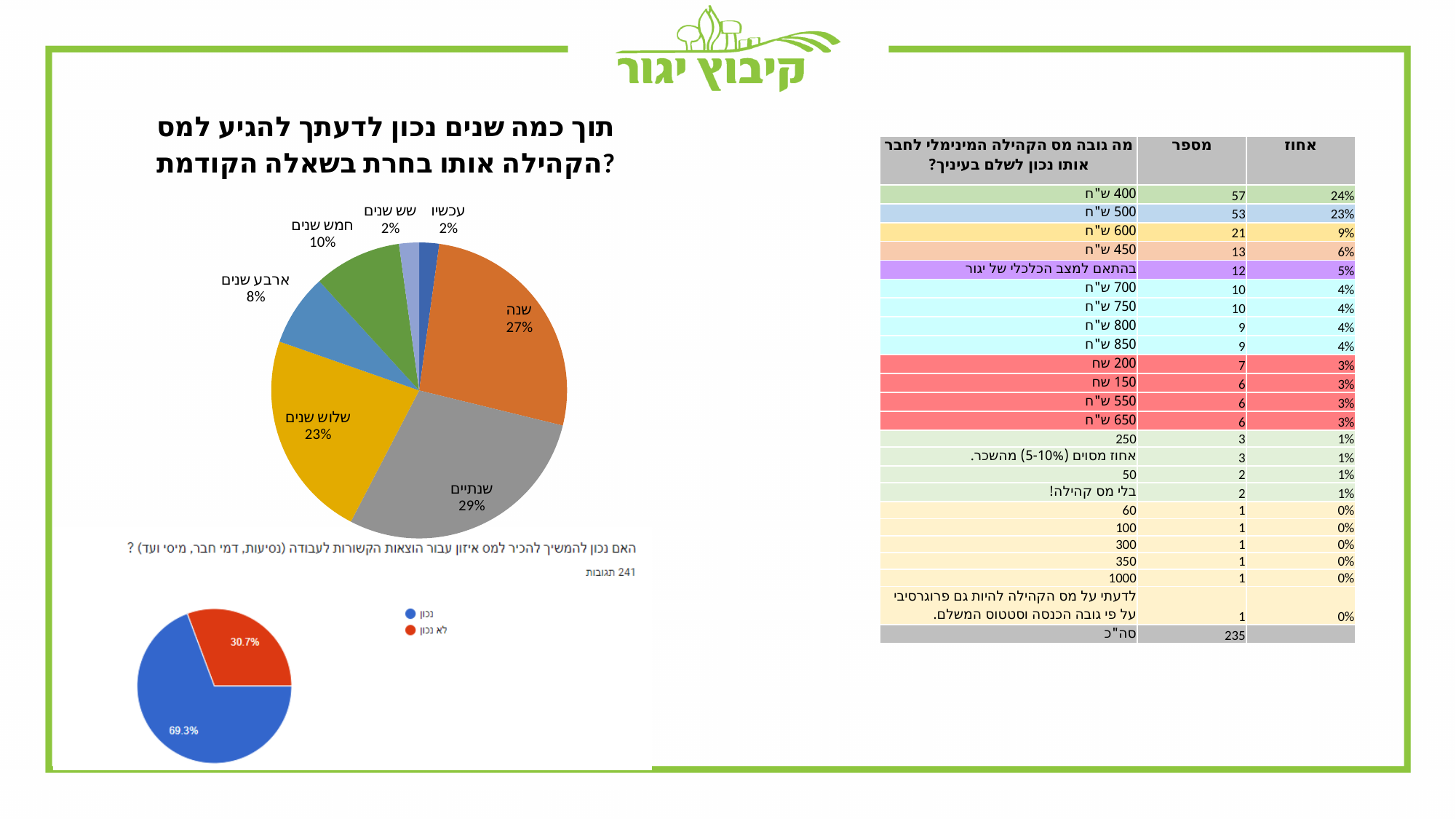
In the bottom pie chart, what share is labelled for לא נכון? 30.7% In the bottom pie chart, what colour is the slice for נכון? blue In the top pie chart, what is the difference in percentage points between שנתיים and שנה? 2 In the top pie chart, what share is labelled for שלוש שנים? 23% In the top pie chart, what is the share for חמש שנים? 10% In the top pie chart, how many slices are there? 7 In the top pie chart, what share is labelled for שנתיים? 29% In the bottom pie chart, what share is labelled for נכון? 69.3% What type of chart is the top-left chart? pie chart In the bottom pie chart, how many entries does the legend list? 2 In the top pie chart, which category has the largest share? שנתיים In the top pie chart, which is larger: שלוש שנים or ארבע שנים? שלוש שנים